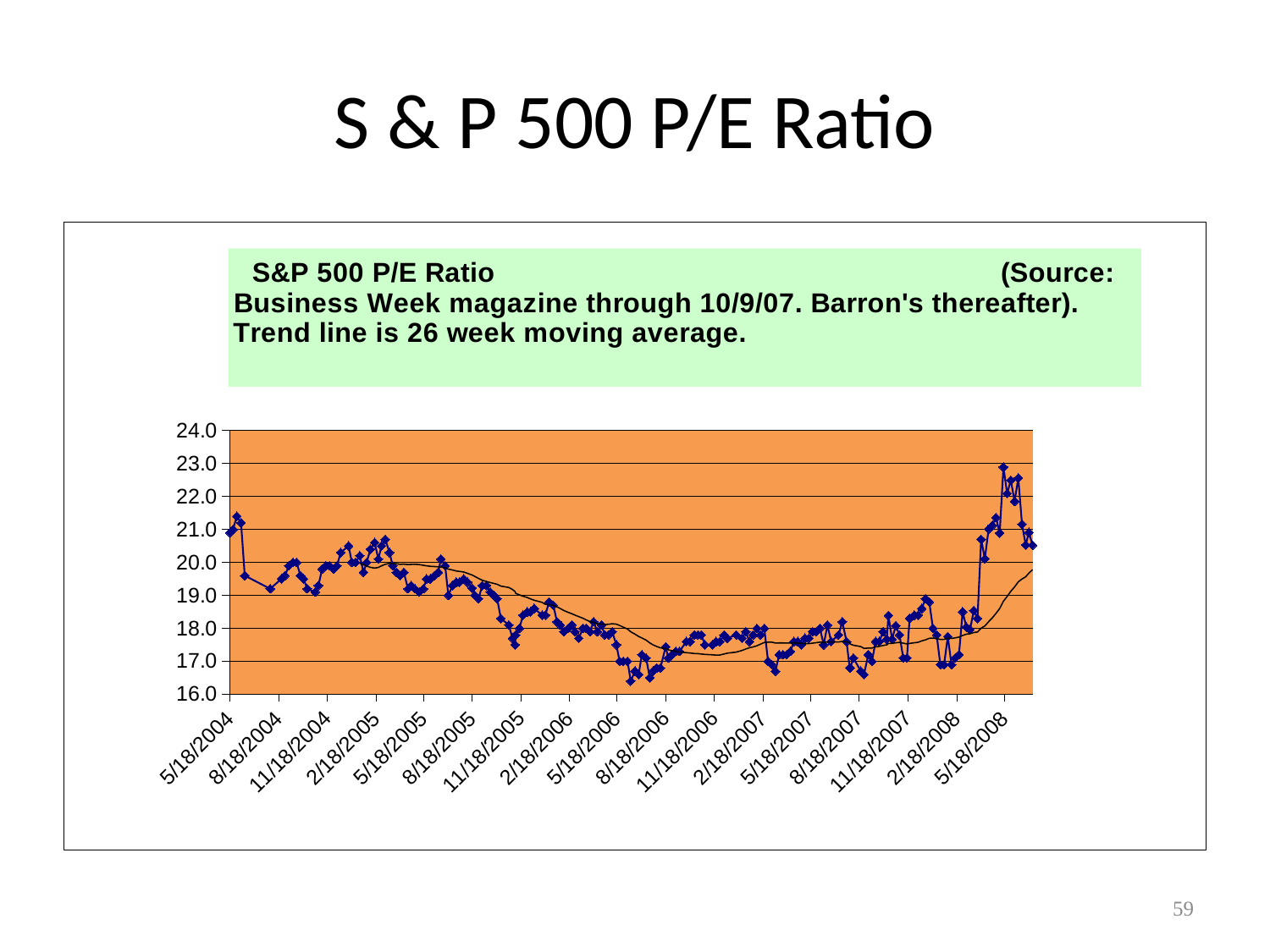
What kind of chart is shown on the slide? line chart What is the title of the chart? S&P 500 P/E Ratio How many date labels are shown on the x axis? 17 According to the chart's caption, what does the trend line represent? 26 week moving average Is the highest P/E ratio plotted near 5/18/2008 greater or less than 22.0? greater Which is larger, the P/E ratio at 5/18/2004 or at 8/18/2006? 5/18/2004 Near which x-axis date label does the P/E ratio reach its highest value? 5/18/2008 Does the P/E ratio generally rise or fall between 5/18/2004 and 8/18/2006? fall Is the P/E ratio at 5/18/2004 greater or less than 20.0? greater Does the P/E ratio generally rise or fall between 8/18/2006 and 5/18/2008? rise Near which x-axis date label does the P/E ratio reach its lowest value? 5/18/2006 Is the P/E ratio around 8/18/2006 greater or less than 18.0? less